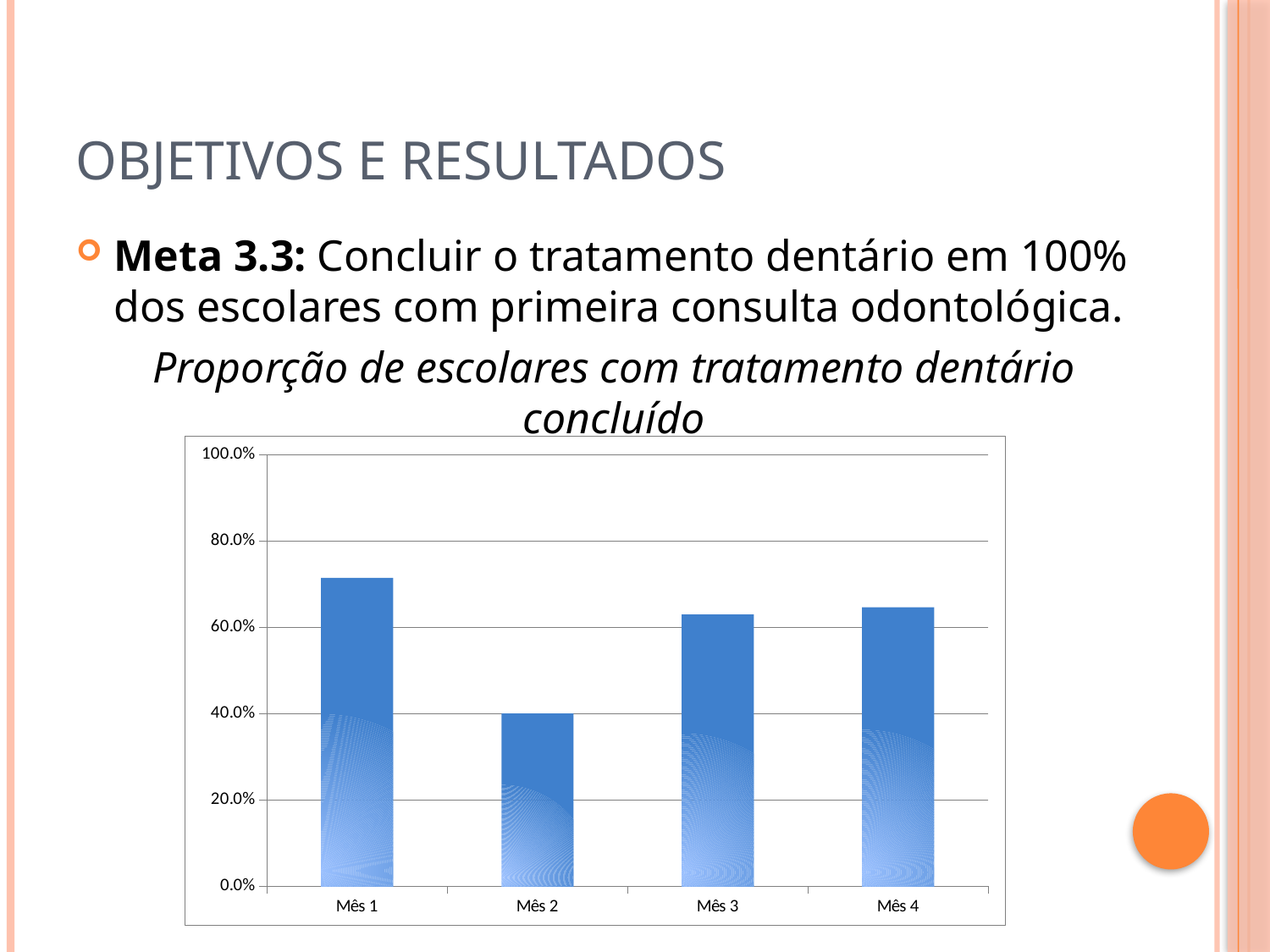
Does the value rise or fall from Mês 1 to Mês 2? fall What kind of chart is shown on the slide? bar chart Which is larger, the value for Mês 1 or the value for Mês 3? Mês 1 Is the value for Mês 1 greater or less than 60.0%? greater Is the value for Mês 3 greater or less than 40.0%? greater Which month has the lowest proportion of students with completed dental treatment? Mês 2 Is the value for Mês 1 greater or less than 80.0%? less Which month has the highest proportion of students with completed dental treatment? Mês 1 What is the title of the chart? Proporção de escolares com tratamento dentário concluído How many categories are shown on the x axis of the chart? 4